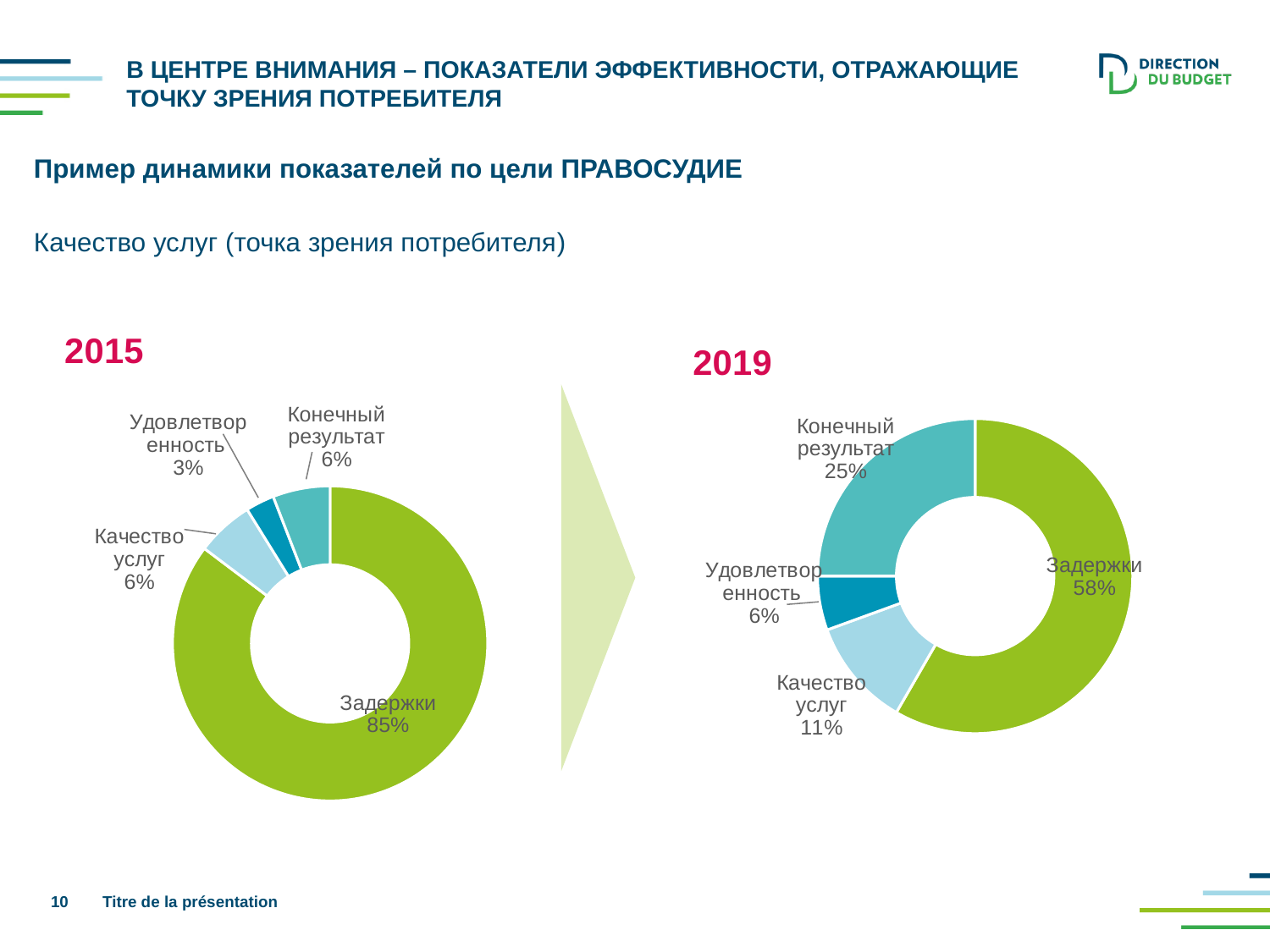
In the 2019 chart, what is the share for Качество услуг? 11% In the 2015 chart, what is the share for Задержки? 85% In the 2015 chart, which category has the largest share? Задержки What kind of chart is used for the 2015 data? Pie (donut) chart In the 2019 chart, which category has the smallest share? Удовлетворенность What is the difference between the share of Задержки in the 2015 chart and in the 2019 chart? 27 percentage points In the 2019 chart, what is the share for Конечный результат? 25% In the 2019 chart, which is larger: Конечный результат or Качество услуг? Конечный результат How many categories does the 2019 chart show? 4 In the 2015 chart, which category has the smallest share? Удовлетворенность In the 2019 chart, what is the difference between Конечный результат and Удовлетворенность? 19 percentage points In the 2015 chart, what is the share for Удовлетворенность? 3%